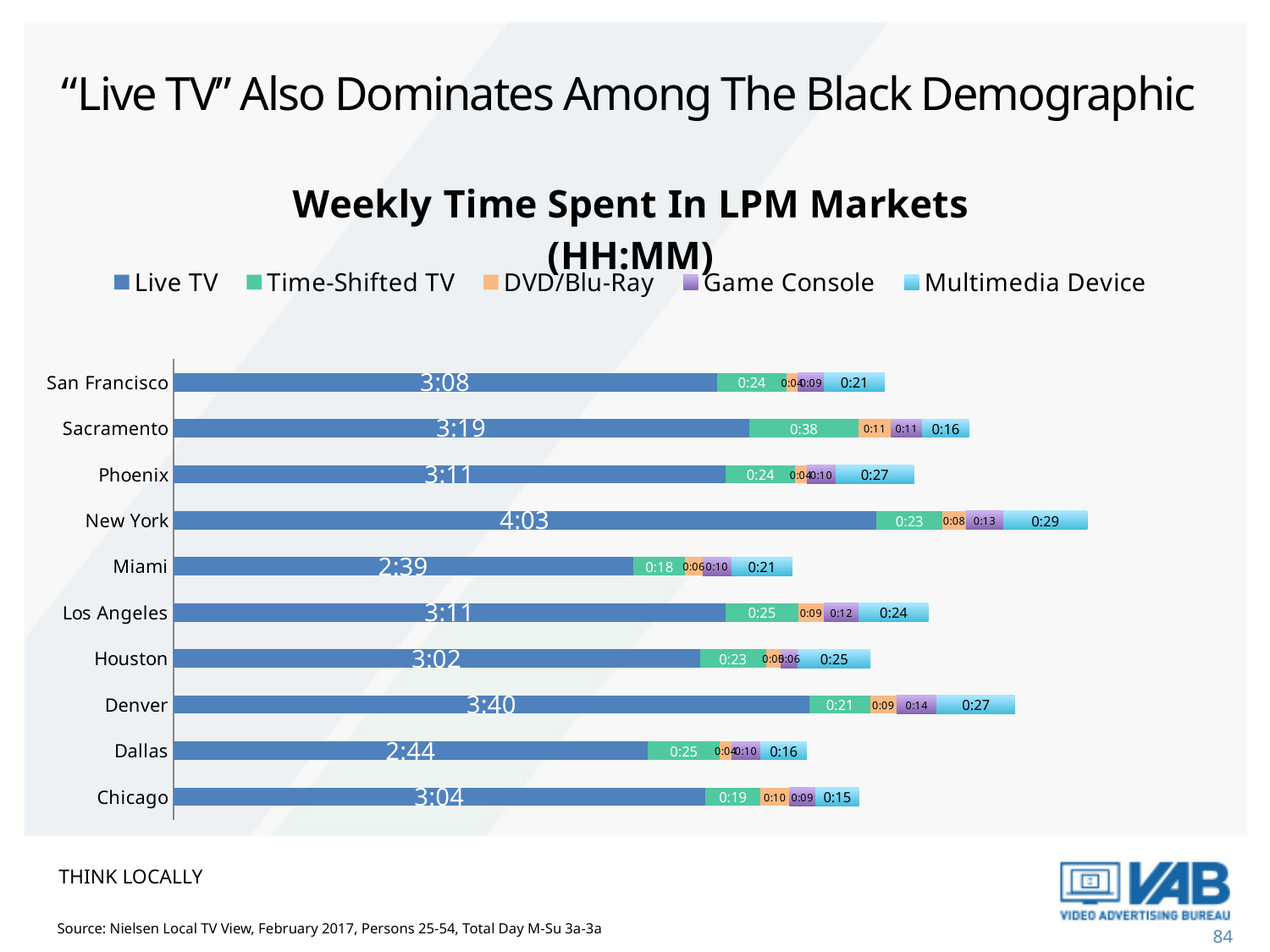
What kind of chart is shown on the slide? Stacked bar chart How many series does the legend list? 5 What is the Live TV value for New York? 4:03 What is the Time-Shifted TV value for Sacramento? 0:38 What is the title of the chart? Weekly Time Spent In LPM Markets (HH:MM) Which market has the highest Live TV value? New York What is the Game Console value for Denver? 0:14 How many markets are shown on the chart? 10 Which is larger, the Live TV value for Denver or for Dallas? Denver Which market has the lowest Live TV value? Miami What is the Multimedia Device value for Phoenix? 0:27 What is the difference between the Live TV values for New York and Miami? 1:24